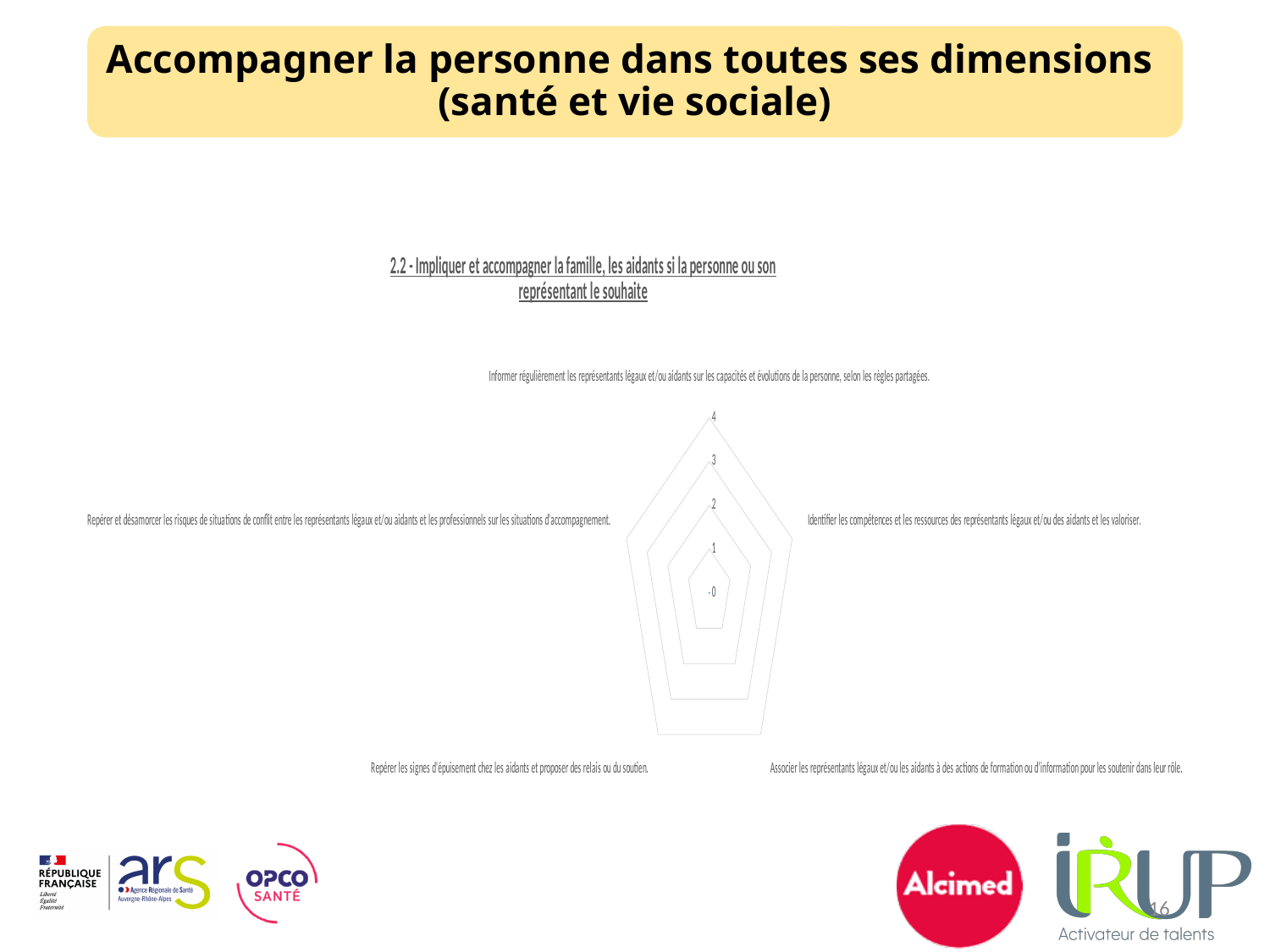
How many categories (axes) does the radar chart have? 5 What is the lowest tick value shown on the radar chart's scale? -0 Which category label appears at the bottom right of the radar chart? Associer les représentants légaux et/ou les aidants à des actions de formation ou d'information pour les soutenir dans leur rôle. Which category label appears on the left side of the radar chart? Repérer et désamorcer les risques de situations de conflit entre les représentants légaux et/ou aidants et les professionnels sur les situations d'accompagnement. What is the title of the radar chart? 2.2 - Impliquer et accompagner la famille, les aidants si la personne ou son représentant le souhaite What kind of chart is shown on the slide? Radar chart Which category label appears at the bottom left of the radar chart? Repérer les signes d'épuisement chez les aidants et proposer des relais ou du soutien. What is the highest tick value shown on the radar chart's scale? 4 Which category label appears on the right side of the radar chart? Identifier les compétences et les ressources des représentants légaux et/ou des aidants et les valoriser. Which category label appears at the top of the radar chart? Informer régulièrement les représentants légaux et/ou aidants sur les capacités et évolutions de la personne, selon les règles partagées.